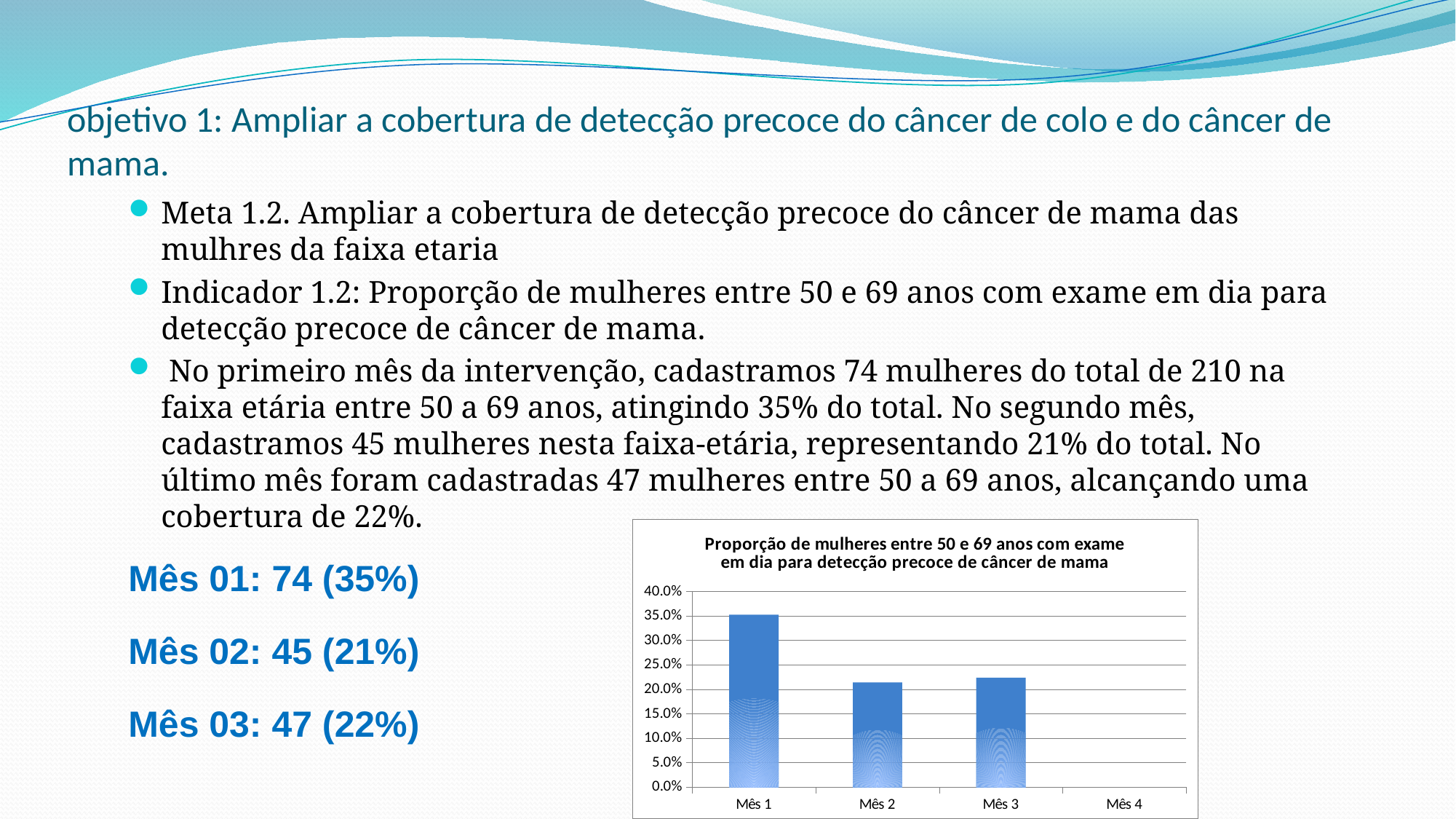
How many categories are labelled on the x axis of the chart? 4 Is the value for Mês 1 greater or less than 30.0%? greater Which is larger, the value for Mês 1 or the value for Mês 2? Mês 1 Is the value for Mês 1 greater or less than 40.0%? less Is the value for Mês 2 greater or less than 25.0%? less What is the highest value shown on the y axis of the chart? 40.0% What kind of chart is shown on the slide? bar chart Does the value rise or fall from Mês 1 to Mês 2? fall What is the title of the chart? Proporção de mulheres entre 50 e 69 anos com exame em dia para detecção precoce de câncer de mama Which month has the highest proportion in the chart? Mês 1